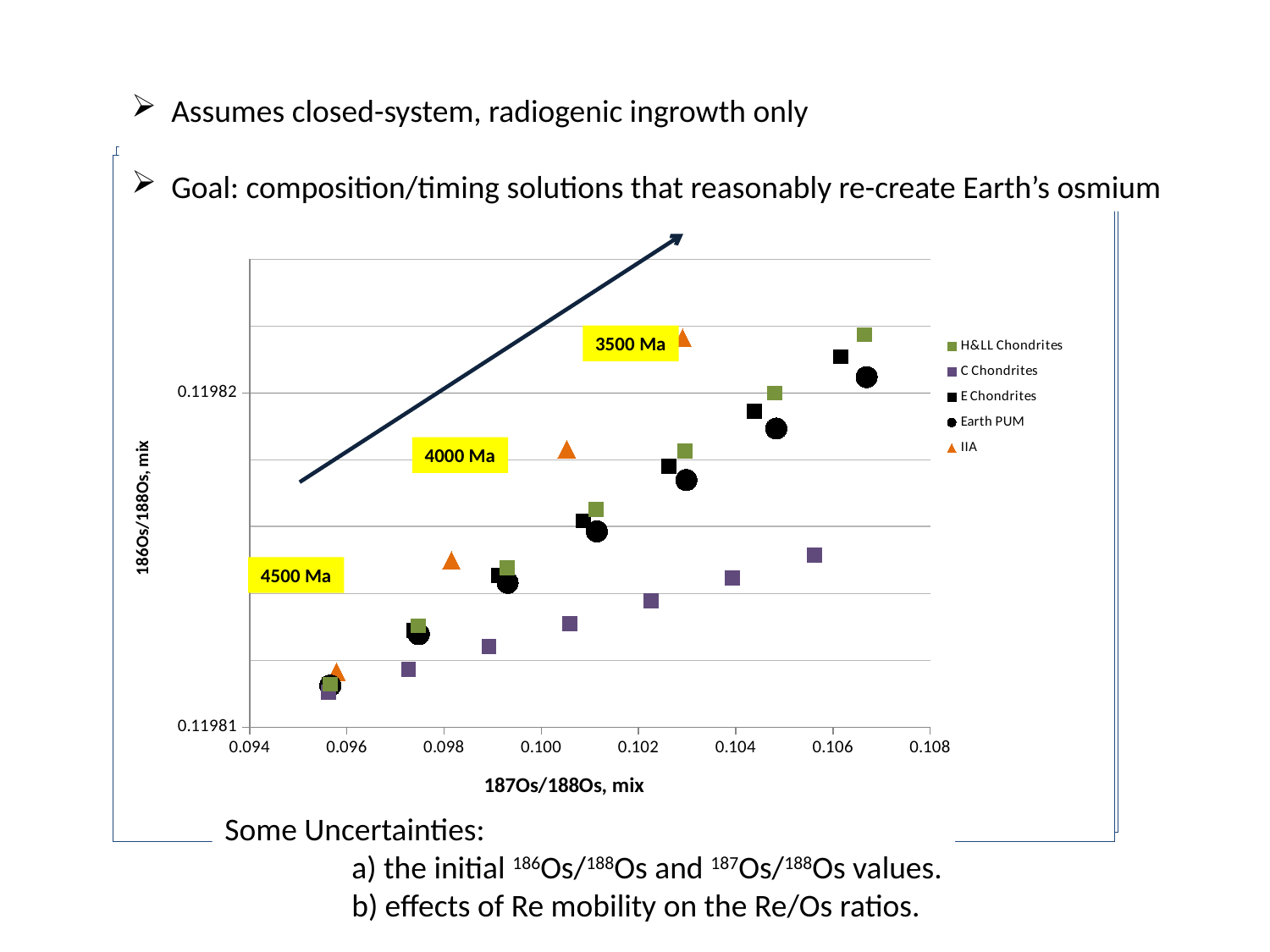
What kind of chart is shown on the slide? scatter chart What is the lowest value labelled on the y axis of the chart? 0.11981 Is the highest IIA point (near 187Os/188Os of 0.103) greater or less than 0.11982 on the y axis? greater At the rightmost cluster of points (187Os/188Os near 0.107), which series is higher: H&LL Chondrites or Earth PUM? H&LL Chondrites What is the title of the y axis of the chart? 186Os/188Os, mix Do the plotted values rise or fall as 187Os/188Os increases along the x axis? rise Which series lies lowest on the chart at 187Os/188Os values around 0.104 to 0.106? C Chondrites How many IIA points are plotted on the chart? 4 Is the rightmost C Chondrites point greater or less than 0.11982 on the y axis? less What is the title of the x axis of the chart? 187Os/188Os, mix How many series does the chart legend list? 5 Which series is plotted with orange triangles? IIA